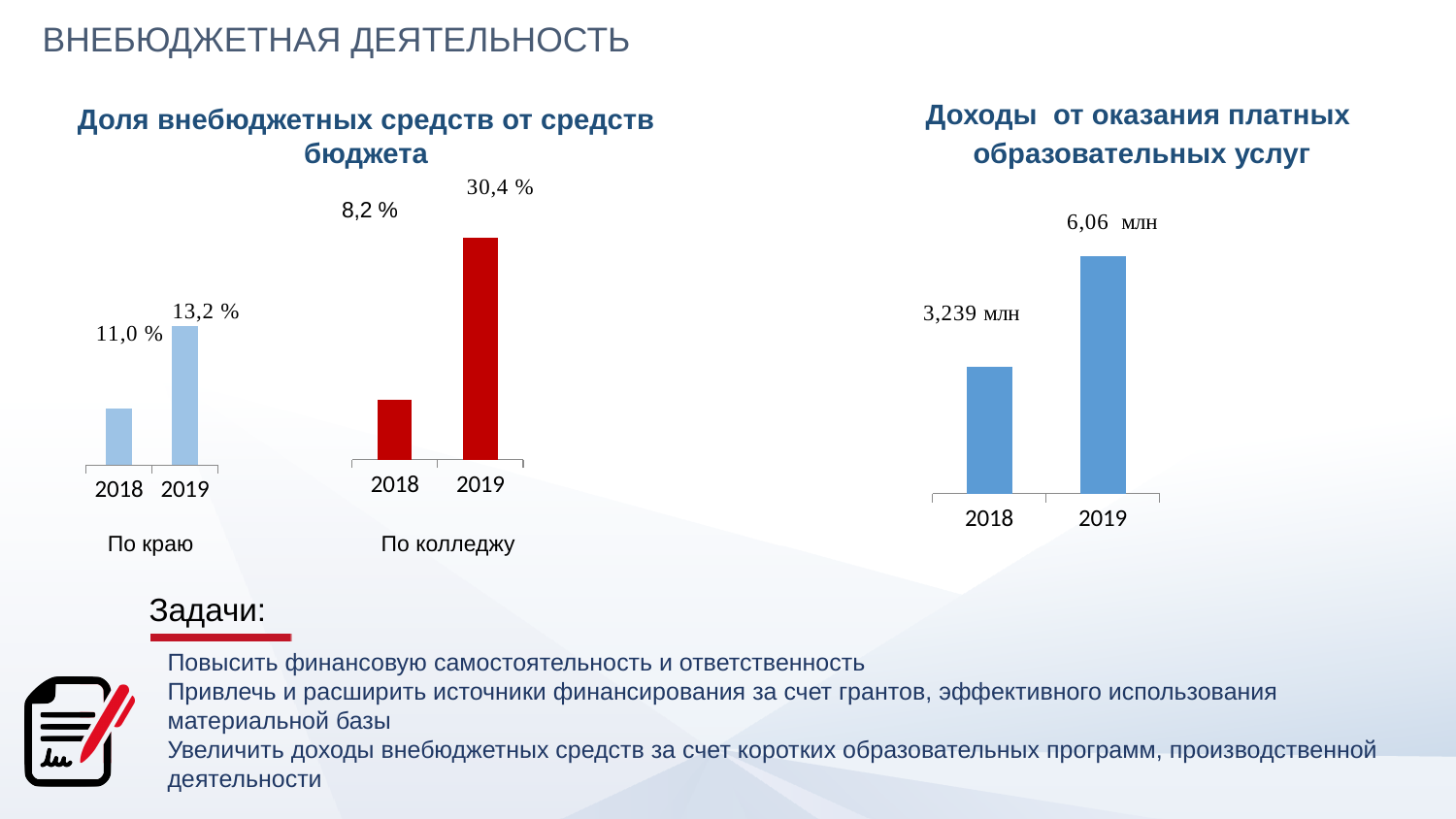
In the 'По колледжу' chart, which year has the highest value? 2019 In the 'По краю' chart, is the value for 2019 larger or smaller than the value for 2018? larger In the 'Доходы от оказания платных образовательных услуг' chart, do the values rise or fall from 2018 to 2019? rise In the 'Доходы от оказания платных образовательных услуг' chart, what is the value for 2019? 6,06 млн In the 'Доходы от оказания платных образовательных услуг' chart, what is the value for 2018? 3,239 млн What kind of chart is the 'Доходы от оказания платных образовательных услуг' chart? bar chart In the 'По краю' chart, what is the value for 2018? 11,0 % In the 'По колледжу' chart, what is the value for 2018? 8,2 % In the 'Доходы от оказания платных образовательных услуг' chart, which year has the lowest value? 2018 In the 'По колледжу' chart, what is the difference between the 2019 and 2018 values? 22,2 % In the 'По краю' chart, what is the value for 2019? 13,2 % In the 'По колледжу' chart, what is the value for 2019? 30,4 %